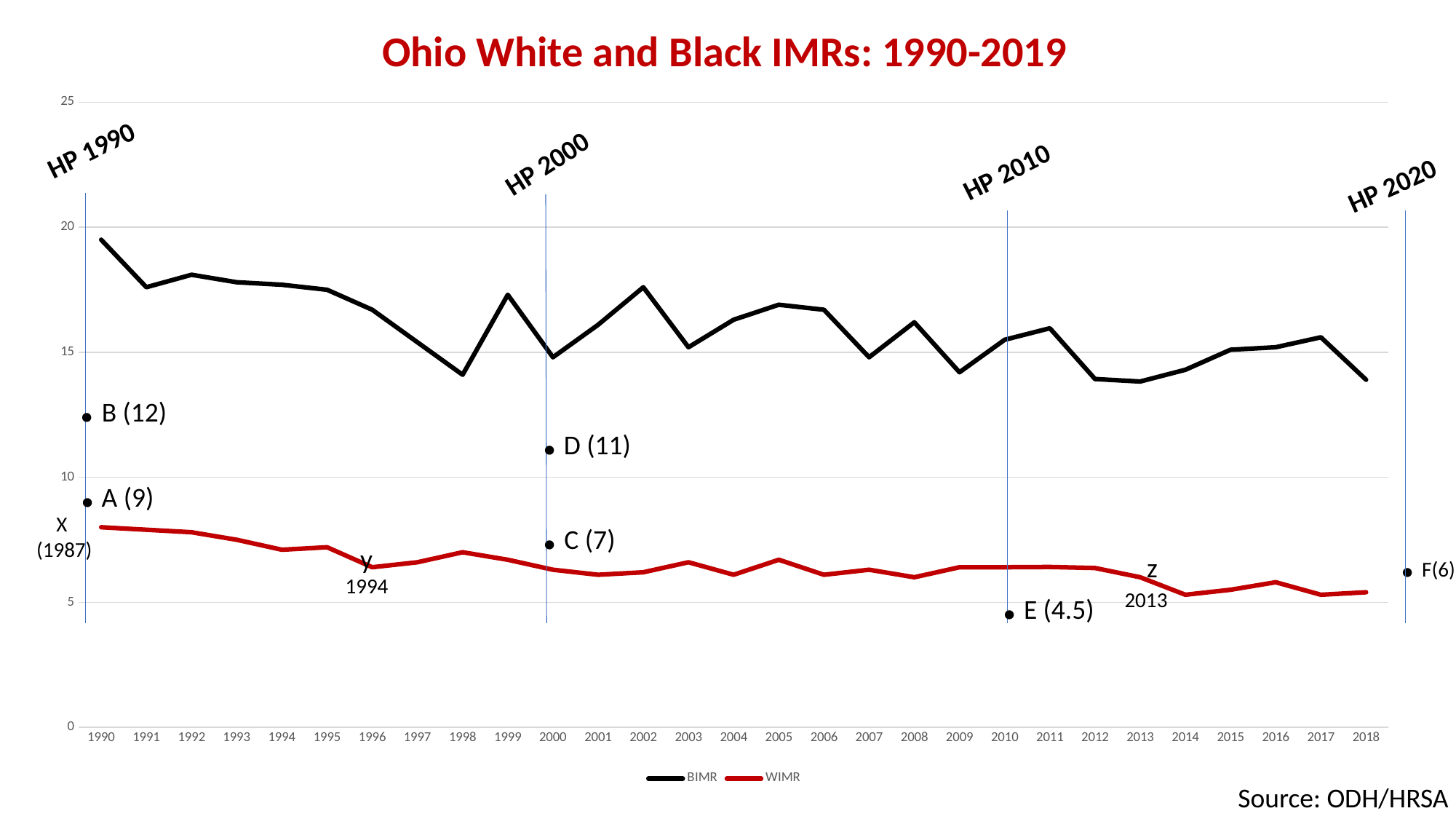
Is the BIMR value for 2018 greater or less than 15? less Which series is drawn in red? WIMR Which series has the larger value in 2005, BIMR or WIMR? BIMR Is the WIMR value for 1990 greater or less than 10? less In which year is the BIMR series at its highest? 1990 In which year is the WIMR series at its highest? 1990 What is the title of the chart? Ohio White and Black IMRs: 1990-2019 What kind of chart is shown on the slide? line chart How many series does the legend list? 2 Is the BIMR value for 1990 greater or less than 15? greater Does the WIMR series generally rise or fall from 1990 to 2018? fall How many years are shown on the x axis? 29